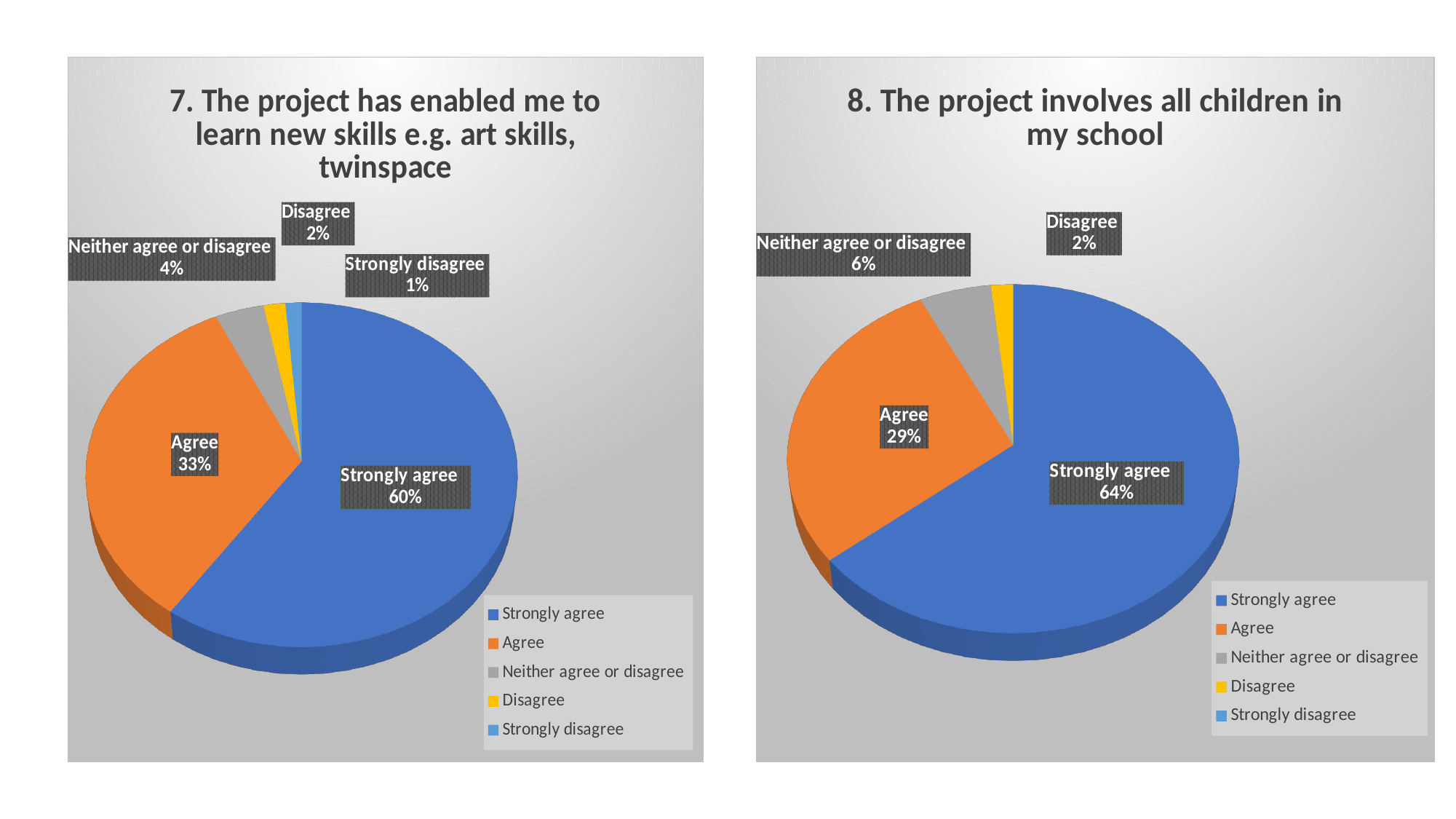
In the left chart (7. The project has enabled me to learn new skills), what percentage is shown for Strongly disagree? 1% In the left chart (7. The project has enabled me to learn new skills), which response has the largest slice? Strongly agree In the left chart (7. The project has enabled me to learn new skills), what is the difference between the Strongly agree and Agree percentages? 27% In the left chart (7. The project has enabled me to learn new skills), what percentage of respondents chose Strongly agree? 60% In the right chart (8. The project involves all children in my school), what percentage of respondents chose Strongly agree? 64% Which chart shows a larger Strongly agree share, the left chart (question 7) or the right chart (question 8)? The right chart (question 8) In the right chart (8. The project involves all children in my school), what is the difference between the Agree and Disagree percentages? 27% In the left chart (7. The project has enabled me to learn new skills), what share is labelled for Agree? 33% How many entries does the legend of the right chart (8. The project involves all children in my school) list? 5 In the right chart (8. The project involves all children in my school), what share is labelled for Neither agree or disagree? 6% What type of chart is used on this slide? Pie chart In the left chart (7. The project has enabled me to learn new skills), which response has the smallest slice? Strongly disagree